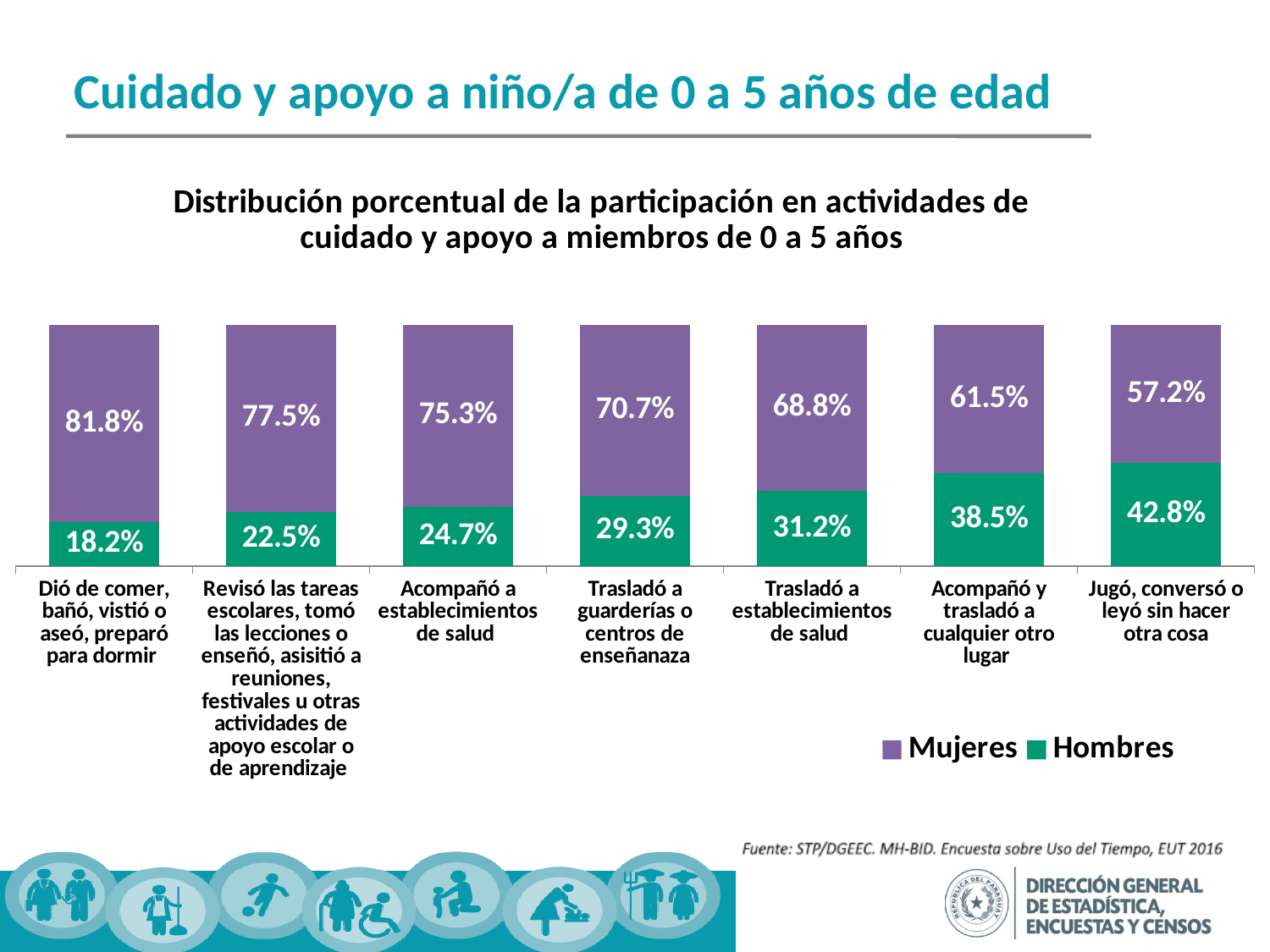
What is the Hombres value for "Trasladó a guarderías o centros de enseñanaza"? 29.3% Do the Hombres values rise or fall from left to right along the x axis? Rise Which category has the highest Mujeres value? Dió de comer, bañó, vistió o aseó, preparó para dormir What is the Mujeres value for "Acompañó a establecimientos de salud"? 75.3% Which is larger for "Trasladó a establecimientos de salud": the Mujeres value or the Hombres value? Mujeres Which category has the lowest Hombres value? Dió de comer, bañó, vistió o aseó, preparó para dormir What is the total of the stacked bar for "Revisó las tareas escolares, tomó las lecciones o enseñó, asistió a reuniones, festivales u otras actividades de apoyo escolar o de aprendizaje"? 100.0% What is the Hombres value for "Jugó, conversó o leyó sin hacer otra cosa"? 42.8% How many categories are shown on the x axis? 7 What kind of chart is shown on the slide? Stacked bar chart How many series does the legend list? 2 What is the difference between the Mujeres and Hombres values for "Acompañó y trasladó a cualquier otro lugar"? 23.0%